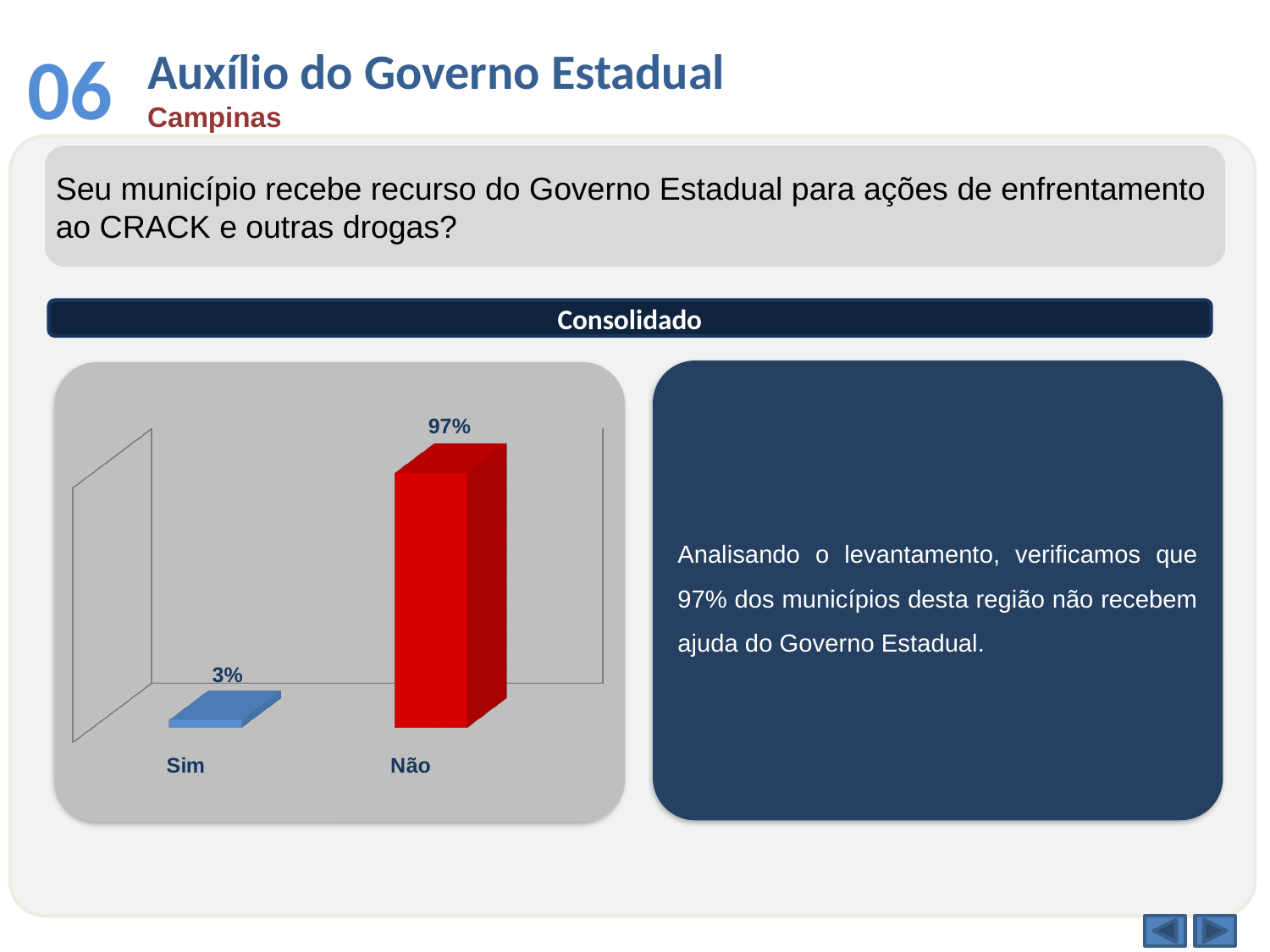
What kind of chart is shown on the slide? Bar chart Which category has the lowest value? Sim What is the value for "Sim"? 3% How many categories are shown in the chart? 2 Which category has the highest value? Não What is the value for "Não"? 97% What colour is the bar for "Sim"? Blue What colour is the bar for "Não"? Red What is the total of the two values shown in the chart? 100% Which is larger, the value for "Sim" or the value for "Não"? Não What is the difference between the values for "Não" and "Sim"? 94%